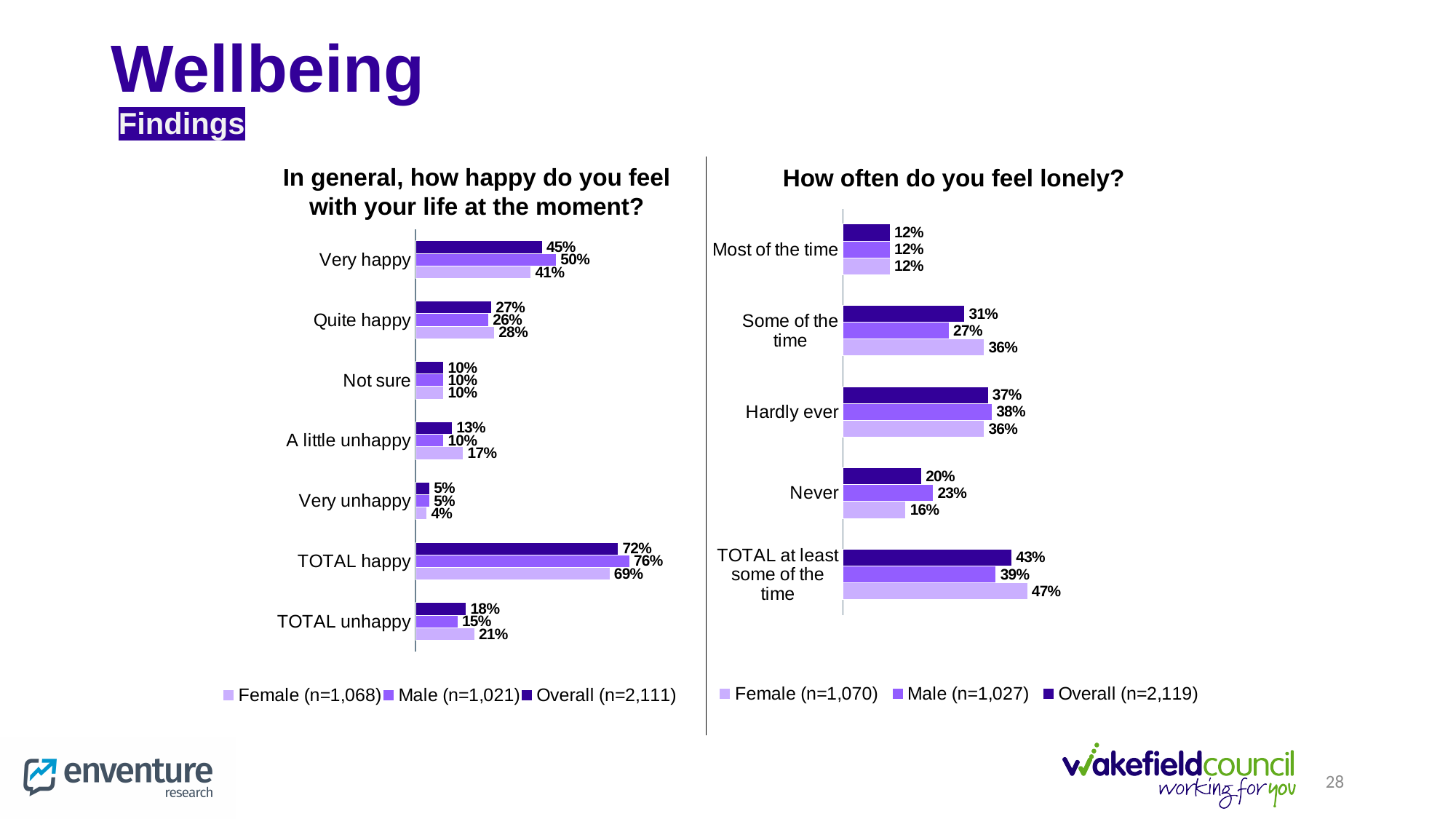
In the 'How often do you feel lonely?' chart, what is the difference between the Female and Male values for TOTAL at least some of the time? 8% In the 'In general, how happy do you feel with your life at the moment?' chart, what is the Overall value for TOTAL unhappy? 18% In the 'How often do you feel lonely?' chart, what is the Male value for Never? 23% In the 'In general, how happy do you feel with your life at the moment?' chart, which category has the lowest Female value? Very unhappy In the 'How often do you feel lonely?' chart, which is larger for Hardly ever: the Male value or the Female value? Male In the 'In general, how happy do you feel with your life at the moment?' chart, how many categories are shown? 7 In the 'How often do you feel lonely?' chart, what is the Female value for Some of the time? 36% In the 'In general, how happy do you feel with your life at the moment?' chart, what is the Female value for TOTAL happy? 69% In the 'How often do you feel lonely?' chart, how many series does the legend list? 3 In the 'In general, how happy do you feel with your life at the moment?' chart, what is the difference between the Female and Male values for A little unhappy? 7% What type of chart is the 'How often do you feel lonely?' chart? Bar chart In the 'In general, how happy do you feel with your life at the moment?' chart, what is the Male value for Very happy? 50%